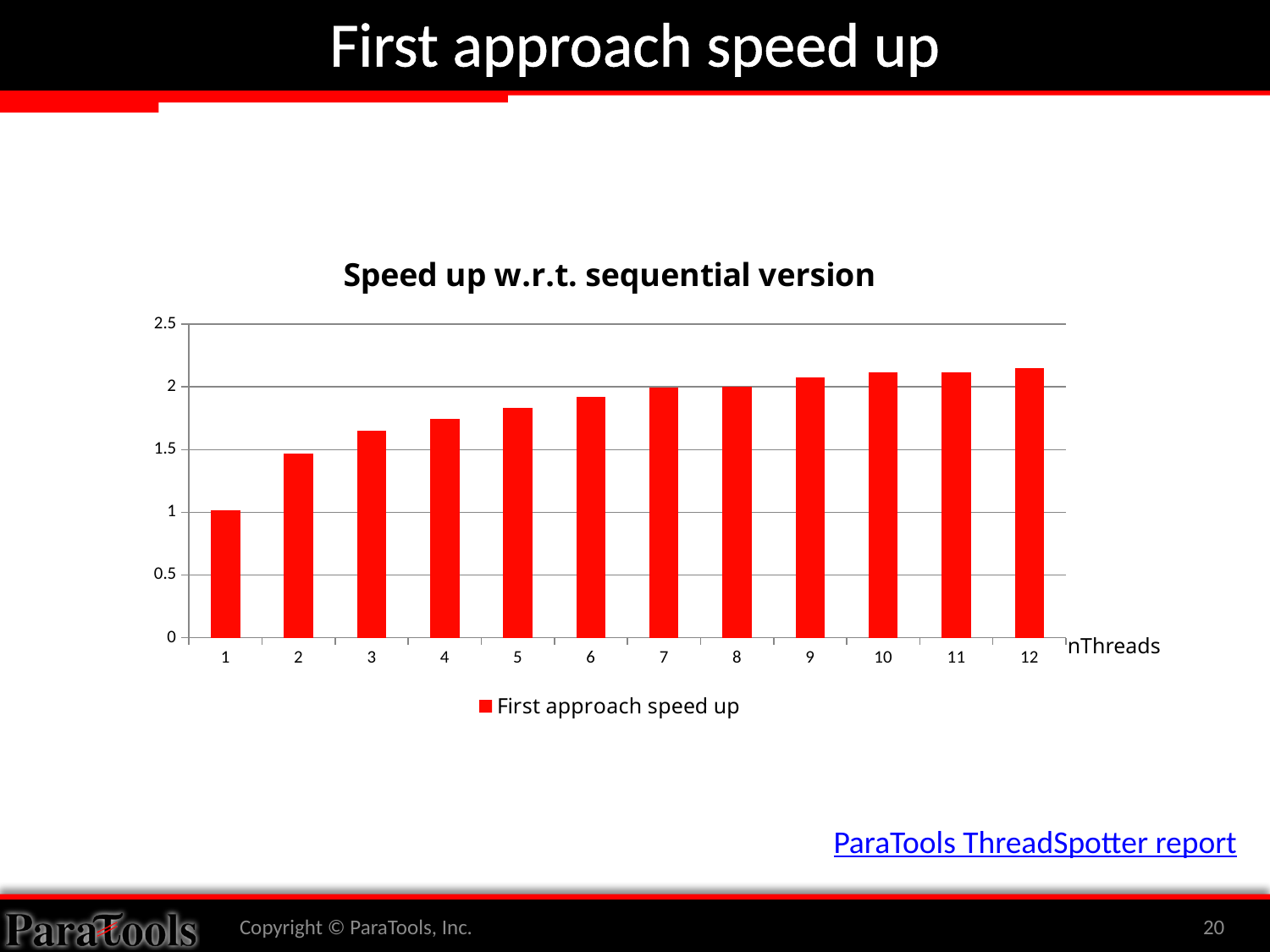
Is the speed up for 2 threads greater or less than 1.5? less How many series does the legend list? 1 What is the title of the chart? Speed up w.r.t. sequential version Do the speed up values rise or fall as the number of threads increases? rise Which has the larger speed up, 2 threads or 3 threads? 3 threads Is the speed up for 3 threads greater or less than 1.5? greater Which number of threads has the lowest speed up? 1 Is the speed up for 6 threads greater or less than 2? less How many thread counts (categories) are plotted on the x axis? 12 Which number of threads has the highest speed up? 12 What kind of chart is shown on the slide? bar chart